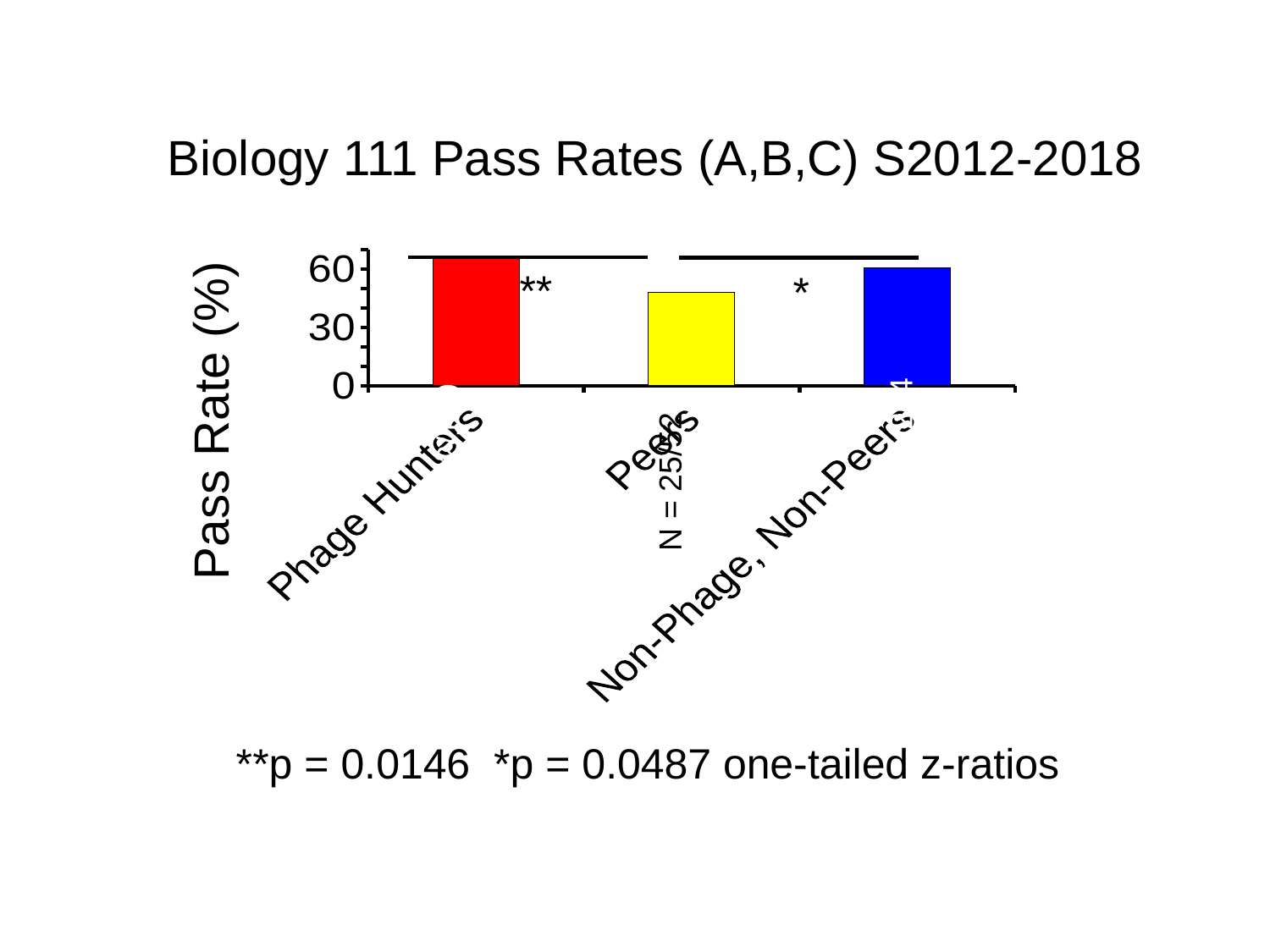
Is the pass rate for Phage Hunters greater or less than 60? greater What is the title of the chart? Biology 111 Pass Rates (A,B,C) S2012-2018 Which has a higher pass rate, Peers or Non-Phage, Non-Peers? Non-Phage, Non-Peers What colour is the bar for Peers? yellow Which category has the highest pass rate? Phage Hunters Which has a higher pass rate, Phage Hunters or Peers? Phage Hunters Is the pass rate for Peers greater or less than 30? greater Is the pass rate for Peers greater or less than 60? less Which category has the lowest pass rate? Peers What is the label of the y axis? Pass Rate (%) What kind of chart is shown on the slide? bar chart How many categories are plotted in the chart? 3